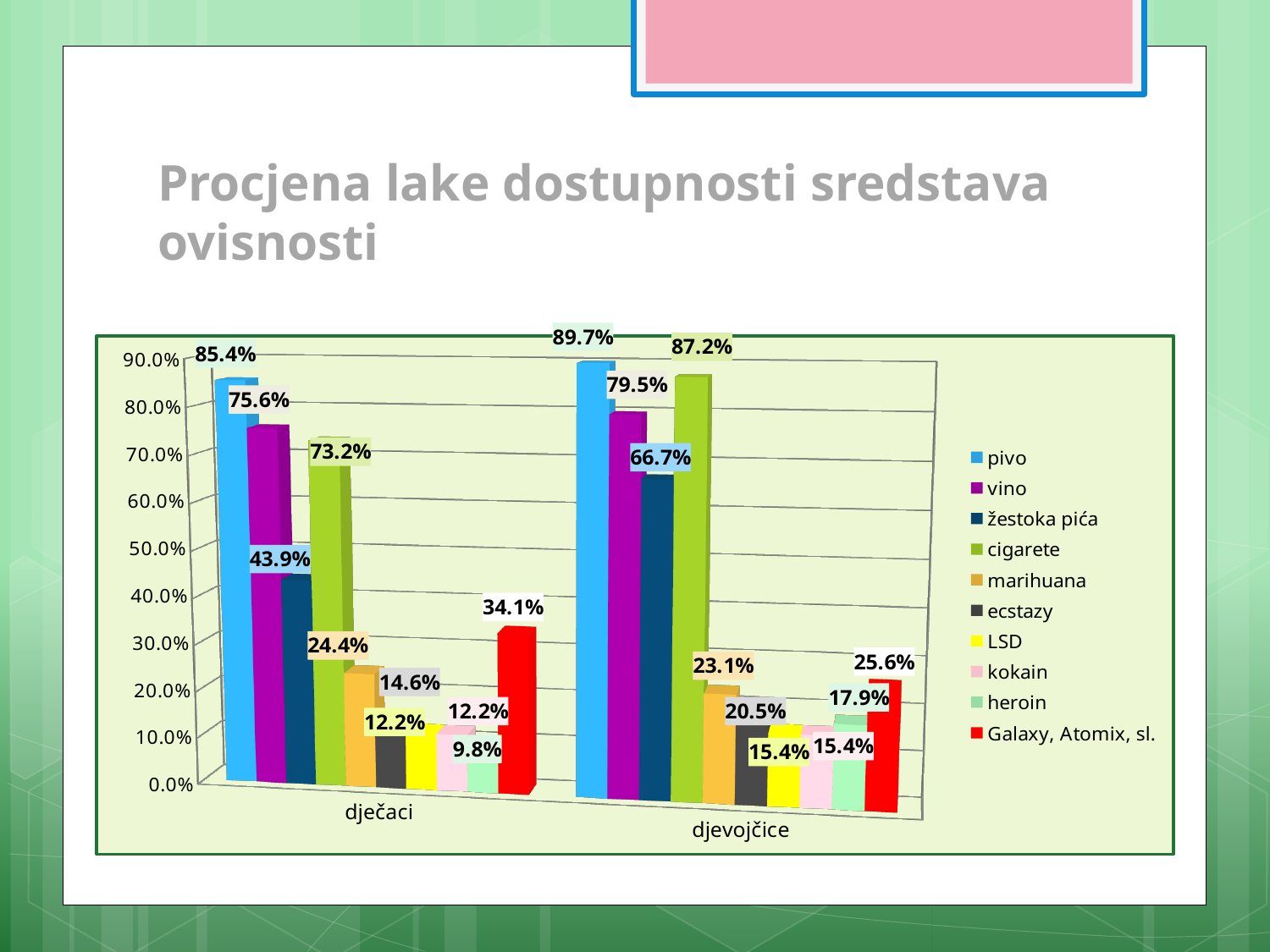
How many series does the legend list? 10 Which is larger: the marihuana value for dječaci or for djevojčice? dječaci Which series has the highest value in the djevojčice category? pivo What is the title of the slide? Procjena lake dostupnosti sredstava ovisnosti Which series has the lowest value in the dječaci category? heroin What is the value for pivo in the dječaci category? 85.4% What is the value for cigarete in the djevojčice category? 87.2% What kind of chart is shown on the slide? bar chart How many categories are shown on the x axis? 2 What is the value for žestoka pića in the djevojčice category? 66.7% What is the difference between the pivo values for djevojčice and dječaci? 4.3% What is the value for Galaxy, Atomix, sl. in the dječaci category? 34.1%